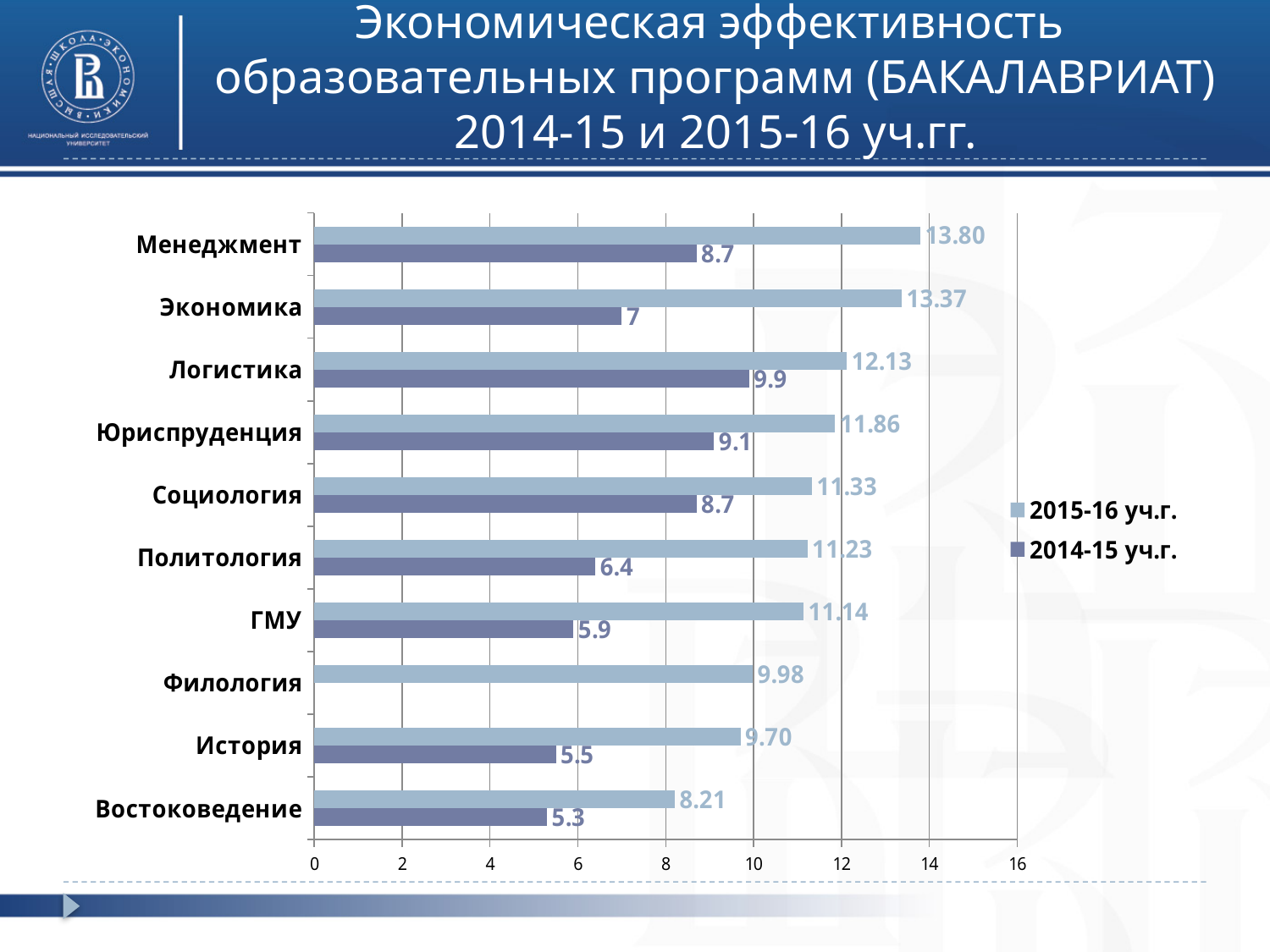
Which is larger: the 2014-15 уч.г. value for Логистика or for Юриспруденция? Логистика What kind of chart is shown on the slide? Bar chart Which category has the lowest value in the 2014-15 уч.г. series? Востоковедение Which category has the highest value in the 2015-16 уч.г. series? Менеджмент What is the difference between the 2015-16 уч.г. and 2014-15 уч.г. values for Политология? 4.83 How many series does the legend list? 2 What is the value for Логистика in the 2014-15 уч.г. series? 9.9 Which category has no bar for the 2014-15 уч.г. series? Филология What is the value for История in the 2014-15 уч.г. series? 5.5 What is the value for Востоковедение in the 2015-16 уч.г. series? 8.21 How many categories are shown on the chart? 10 What is the value for Менеджмент in the 2015-16 уч.г. series? 13.80